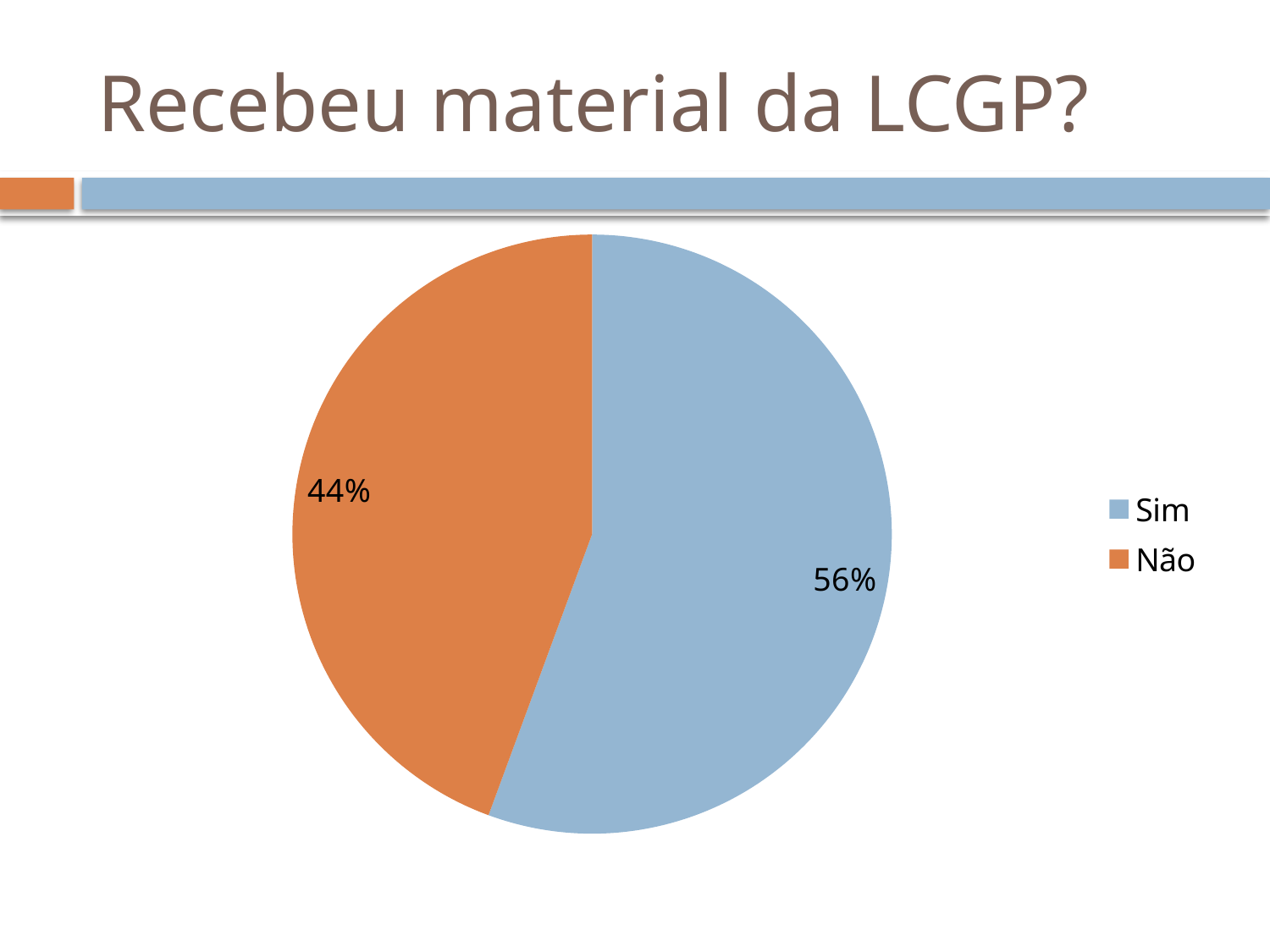
What colour is the Não slice in the pie chart? Orange What share of the pie does the Não slice represent? 44% How many slices does the pie chart have? 2 What percentage of the pie is labelled for Sim? 56% Which slice is larger, Sim or Não? Sim Which category has the smallest slice of the pie? Não Which category has the largest slice of the pie? Sim What kind of chart is shown on the slide? Pie chart What percentage of the pie is labelled for Não? 44% What is the difference in percentage points between the Sim and Não slices? 12 What is the title of the slide containing the chart? Recebeu material da LCGP? How many entries does the legend list? 2